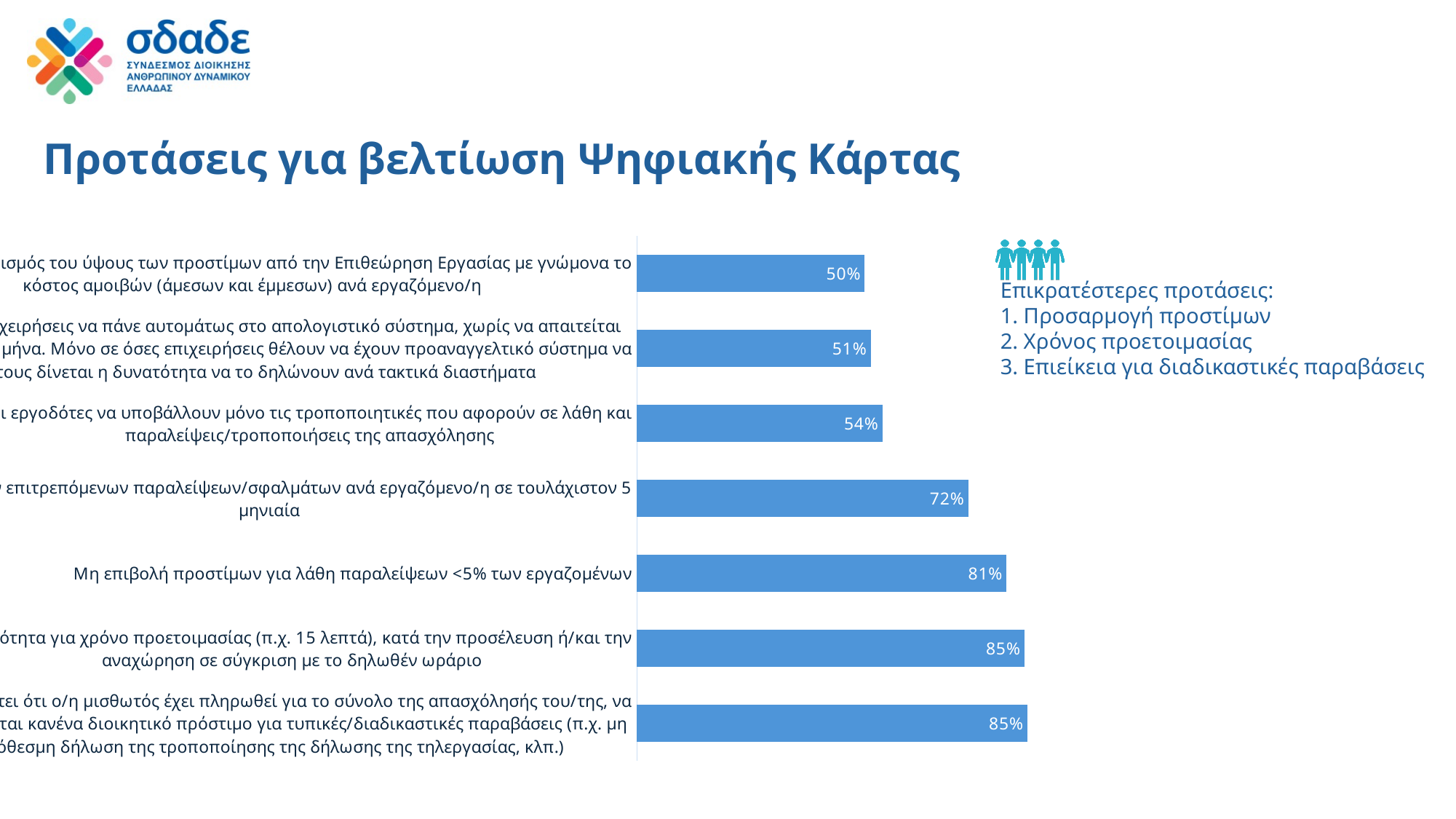
What is the difference between the bottom bar (85%) and the top bar (50%)? 35% What is the value of the topmost bar in the chart? 50% Which is larger: the fourth bar from the top (72%) or the third bar from the top (54%)? the fourth bar from the top (72%) What kind of chart is shown on the slide? bar chart What is the value of the bottom bar in the chart? 85% How many bars in the chart have a value of 85%? 2 How many bars does the chart contain? 7 What is the lowest value shown in the chart? 50% What is the title of the slide containing the chart? Προτάσεις για βελτίωση Ψηφιακής Κάρτας What is the value for the proposal "Μη επιβολή προστίμων για λάθη παραλείψεων <5% των εργαζομένων"? 81% What is the highest value shown in the chart? 85% Do the bar values increase or decrease going from the top of the chart to the bottom? increase